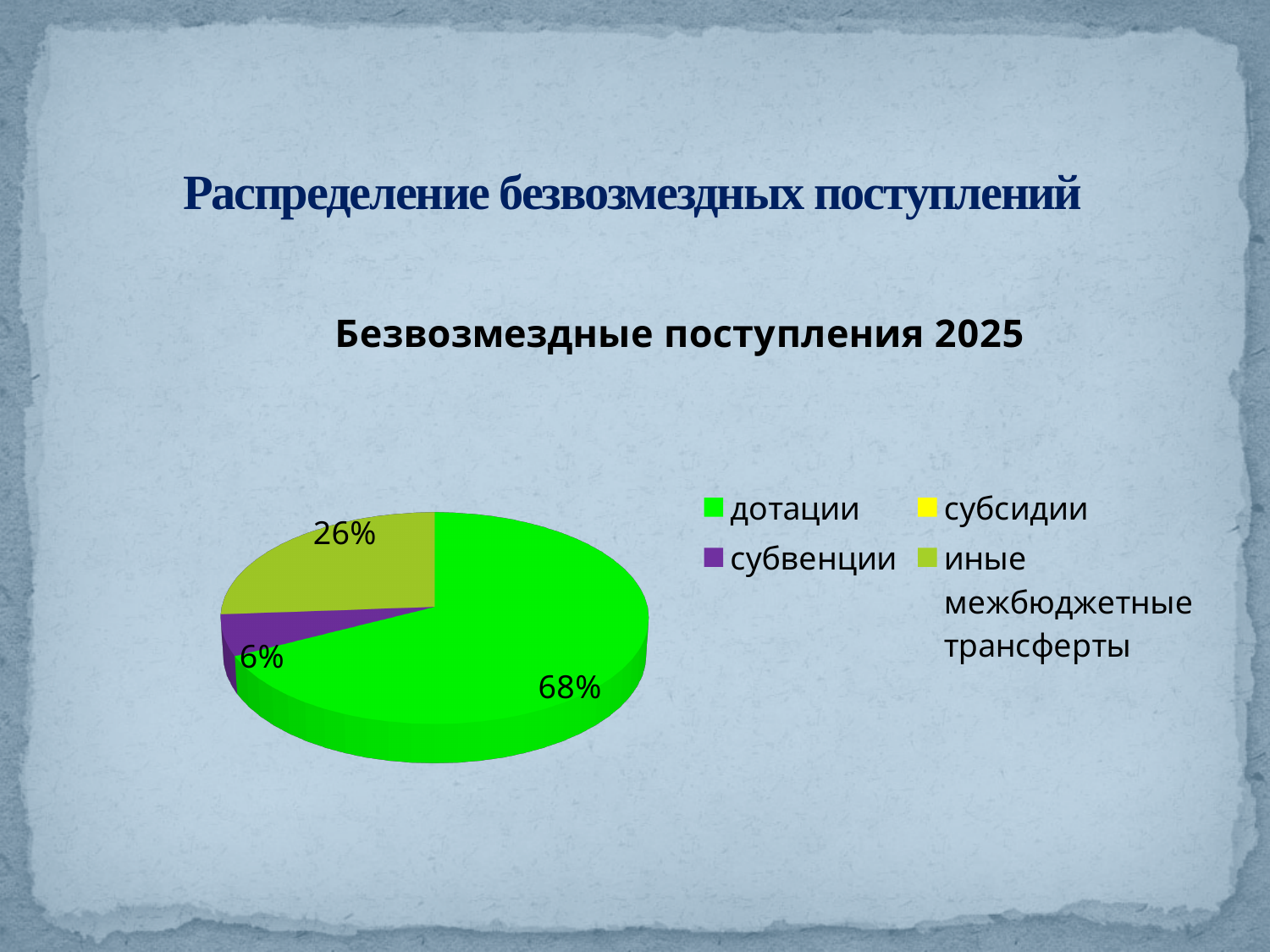
By how many percentage points does the дотации slice exceed the субвенции slice? 62 What share of the pie does иные межбюджетные трансферты account for? 26% What share of the pie does дотации account for? 68% What is the title of the chart? Безвозмездные поступления 2025 Which category has the largest slice of the pie? дотации What colour is the slice for дотации? green By how many percentage points does the иные межбюджетные трансферты slice exceed the субвенции slice? 20 Which is larger, the slice for субвенции or the slice for иные межбюджетные трансферты? иные межбюджетные трансферты How many categories does the legend list? 4 What kind of chart is shown on the slide? pie chart What share of the pie does субвенции account for? 6% By how many percentage points does the дотации slice exceed the иные межбюджетные трансферты slice? 42